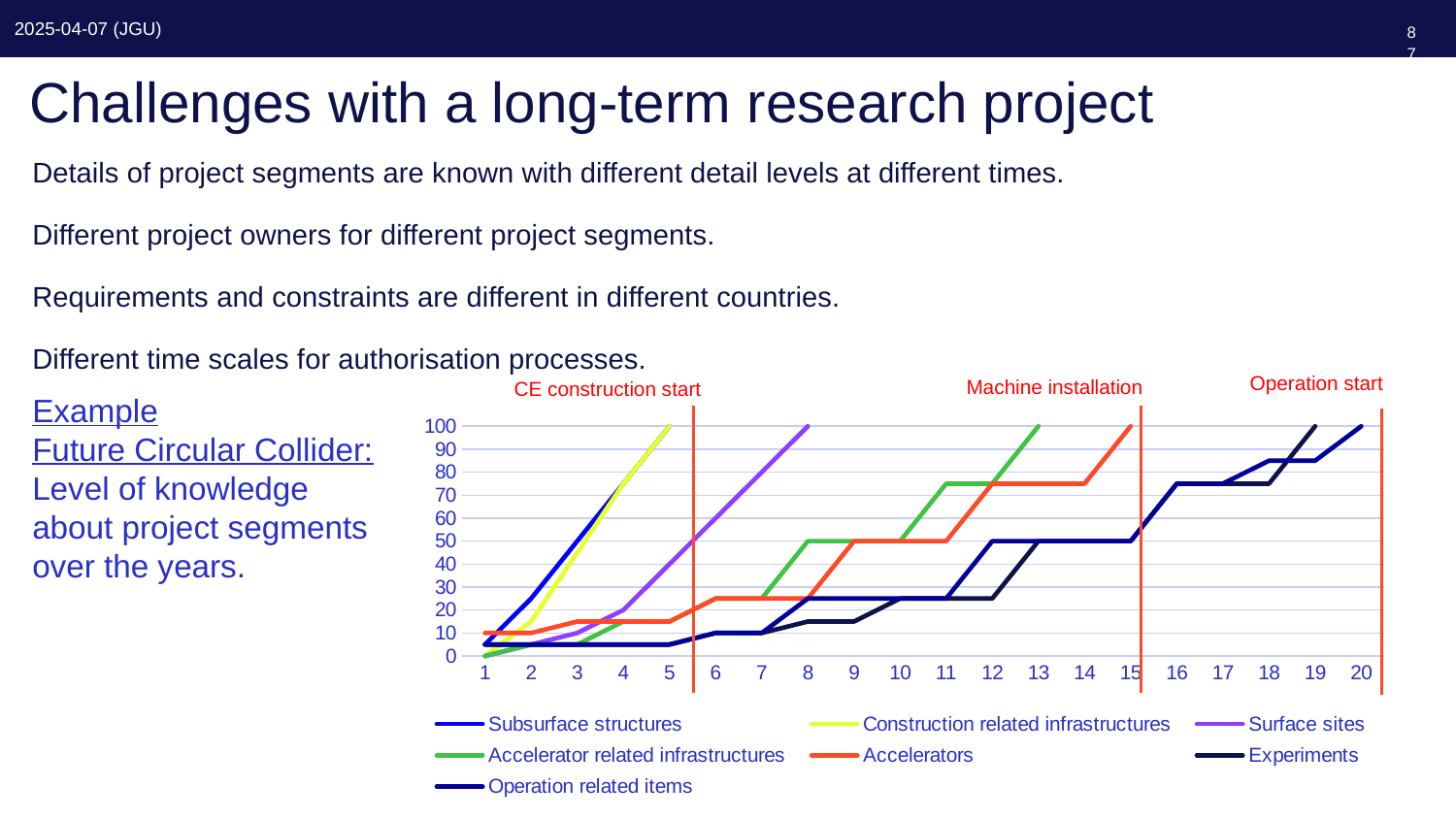
At year 10, which is larger: the value for Accelerators or the value for Experiments? Accelerators Does the Operation related items line rise or fall from year 1 to year 20? rise What value does the Accelerators line reach at year 15? 100 How many series does the chart legend list? 7 Is the value for Experiments at year 12 greater or less than 40? less What value does the Surface sites line reach at year 8? 100 Is the value for Accelerator related infrastructures at year 11 greater or less than 60? greater Is the value for Surface sites at year 6 greater or less than 40? greater How many points (years) are shown along the x axis of the chart? 20 What label is given to the first vertical red line on the chart? CE construction start What kind of chart is shown on the slide? line chart